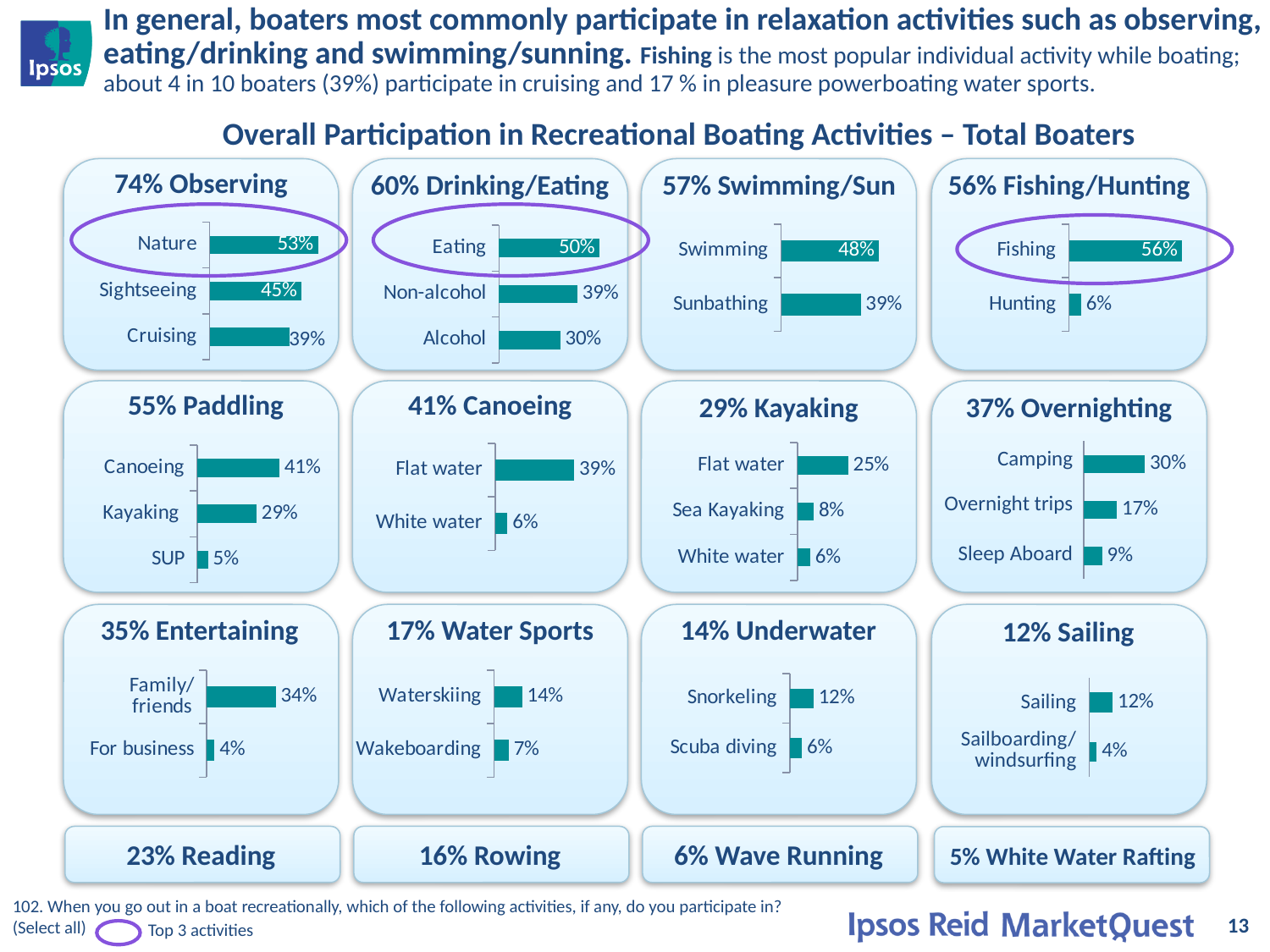
How many categories are shown in the '29% Kayaking' chart? 3 In the '74% Observing' chart, what is the value for Sightseeing? 45% In the '17% Water Sports' chart, what is the difference between Waterskiing and Wakeboarding? 7% In the '41% Canoeing' chart, which is larger, Flat water or White water? Flat water In the '57% Swimming/Sun' chart, what is the difference between Swimming and Sunbathing? 9% In the '60% Drinking/Eating' chart, what is the value for Alcohol? 30% In the '12% Sailing' chart, what is the value for Sailboarding/windsurfing? 4% What kind of chart is used in the '35% Entertaining' panel? Bar chart In the '14% Underwater' chart, what is the value for Scuba diving? 6% In the '55% Paddling' chart, which category has the highest value? Canoeing In the '56% Fishing/Hunting' chart, which category has the lowest value? Hunting In the '37% Overnighting' chart, what is the value for Overnight trips? 17%